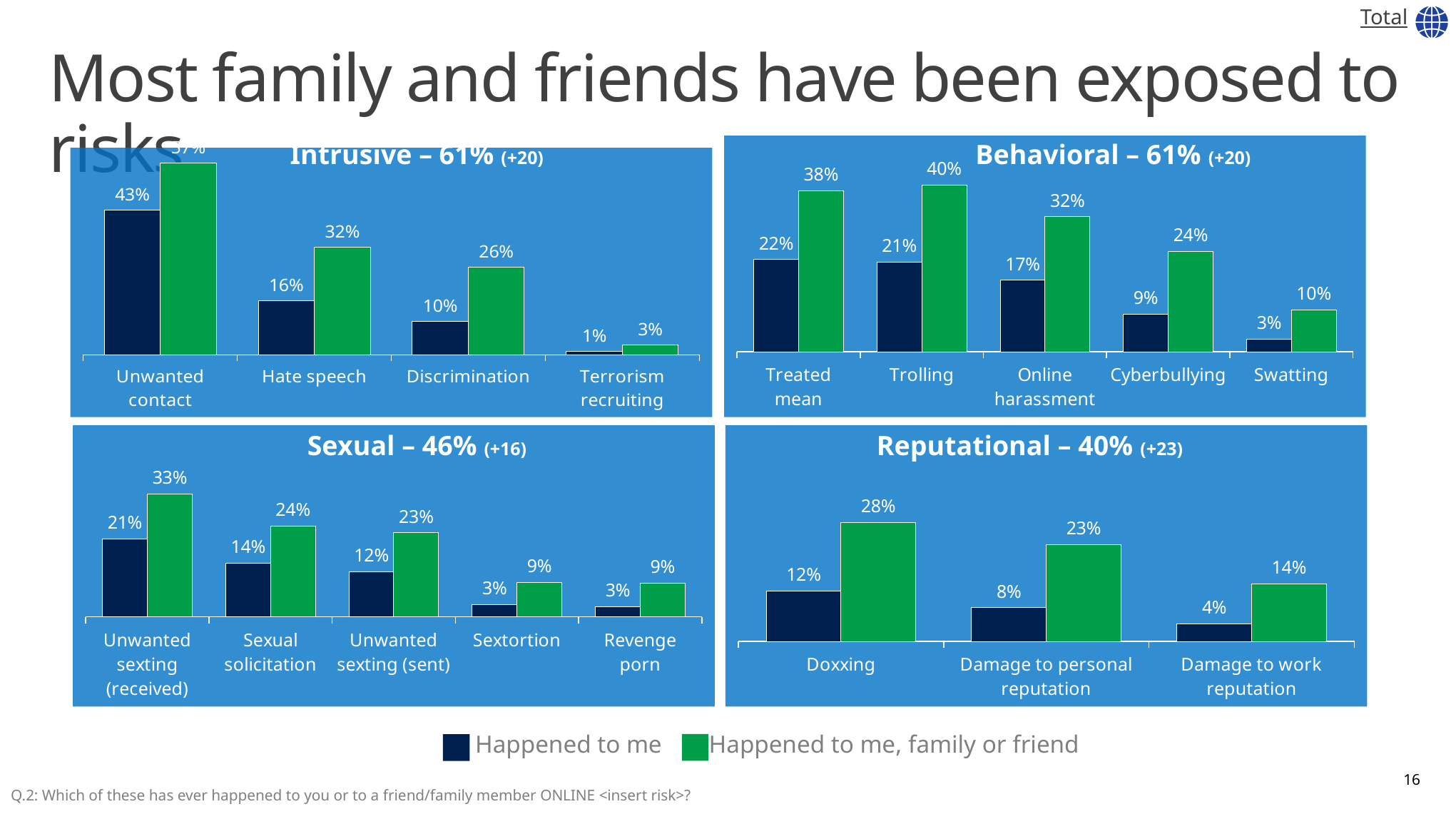
In the Behavioral chart, which category has the highest 'Happened to me, family or friend' value? Trolling In the Intrusive chart, which category has the lowest 'Happened to me' value? Terrorism recruiting In the Reputational chart, which is larger: the 'Happened to me' value for Doxxing or for Damage to work reputation? Doxxing How many categories are shown in the Sexual chart? 5 In the Reputational chart, what is the 'Happened to me, family or friend' value for Doxxing? 28% In the Behavioral chart, do the 'Happened to me' values rise or fall from Treated mean to Swatting? Fall What overall percentage is shown in the title of the Sexual chart? 46% In the Behavioral chart, what is the value for Trolling in the 'Happened to me, family or friend' series? 40% How many series does the legend list? 2 In the Intrusive chart, what is the difference between the 'Happened to me, family or friend' and 'Happened to me' values for Hate speech? 16% What type of chart is the Reputational chart? Bar chart In the Sexual chart, what is the 'Happened to me' value for Sexual solicitation? 14%